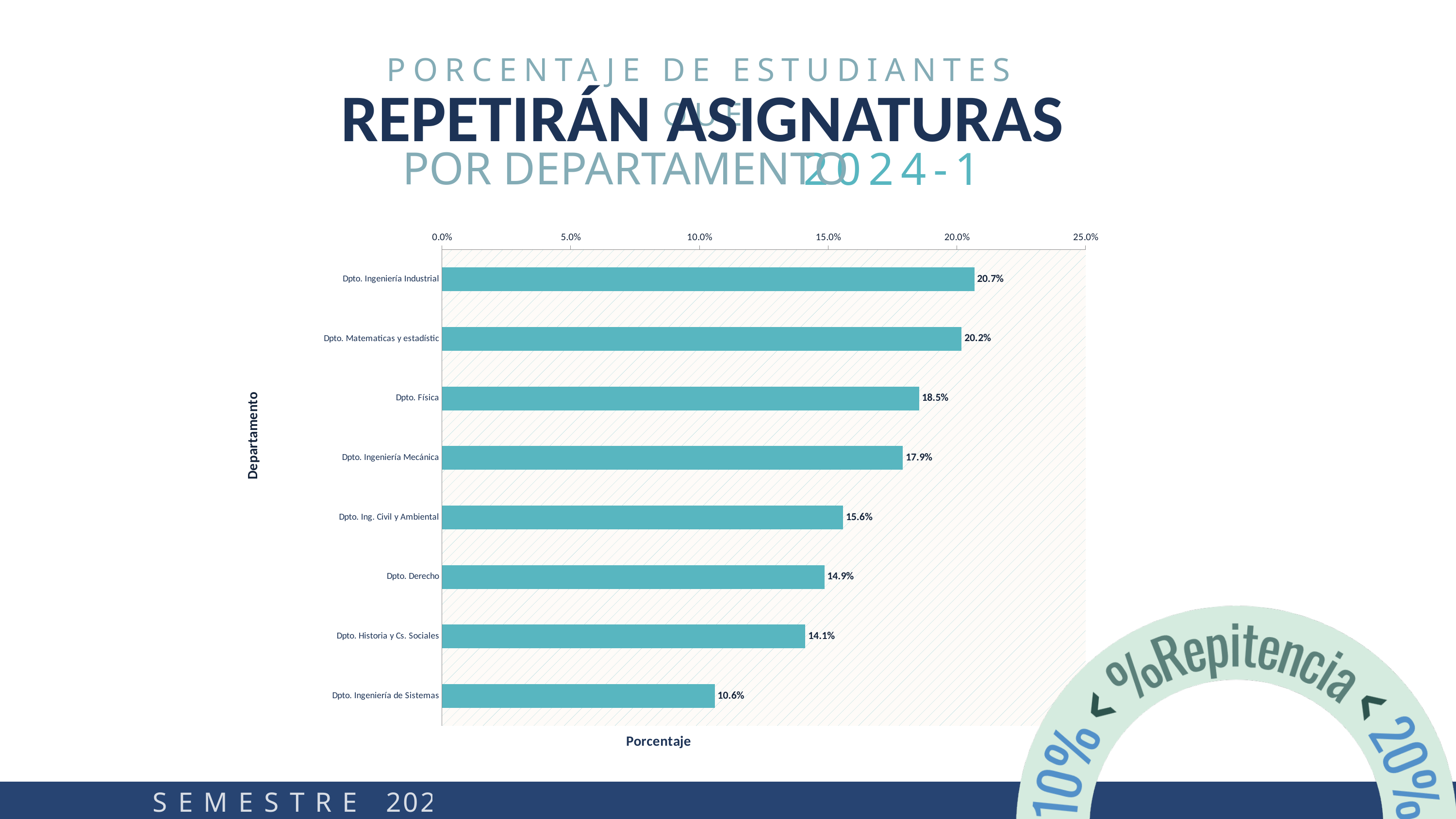
What is the label of the horizontal axis? Porcentaje What is the value for Dpto. Ingeniería Industrial? 20.7% What is the value for Dpto. Física? 18.5% What is the value for Dpto. Ingeniería de Sistemas? 10.6% What is the difference between Dpto. Ingeniería Industrial and Dpto. Ingeniería de Sistemas? 10.1% Is the value for Dpto. Historia y Cs. Sociales greater or less than 15.0%? less Which department has the lowest percentage? Dpto. Ingeniería de Sistemas How many departments are shown in the chart? 8 What is the value for Dpto. Derecho? 14.9% What kind of chart is shown on the slide? bar chart Which is larger, the value for Dpto. Ingeniería Mecánica or Dpto. Ing. Civil y Ambiental? Dpto. Ingeniería Mecánica Which department has the highest percentage? Dpto. Ingeniería Industrial